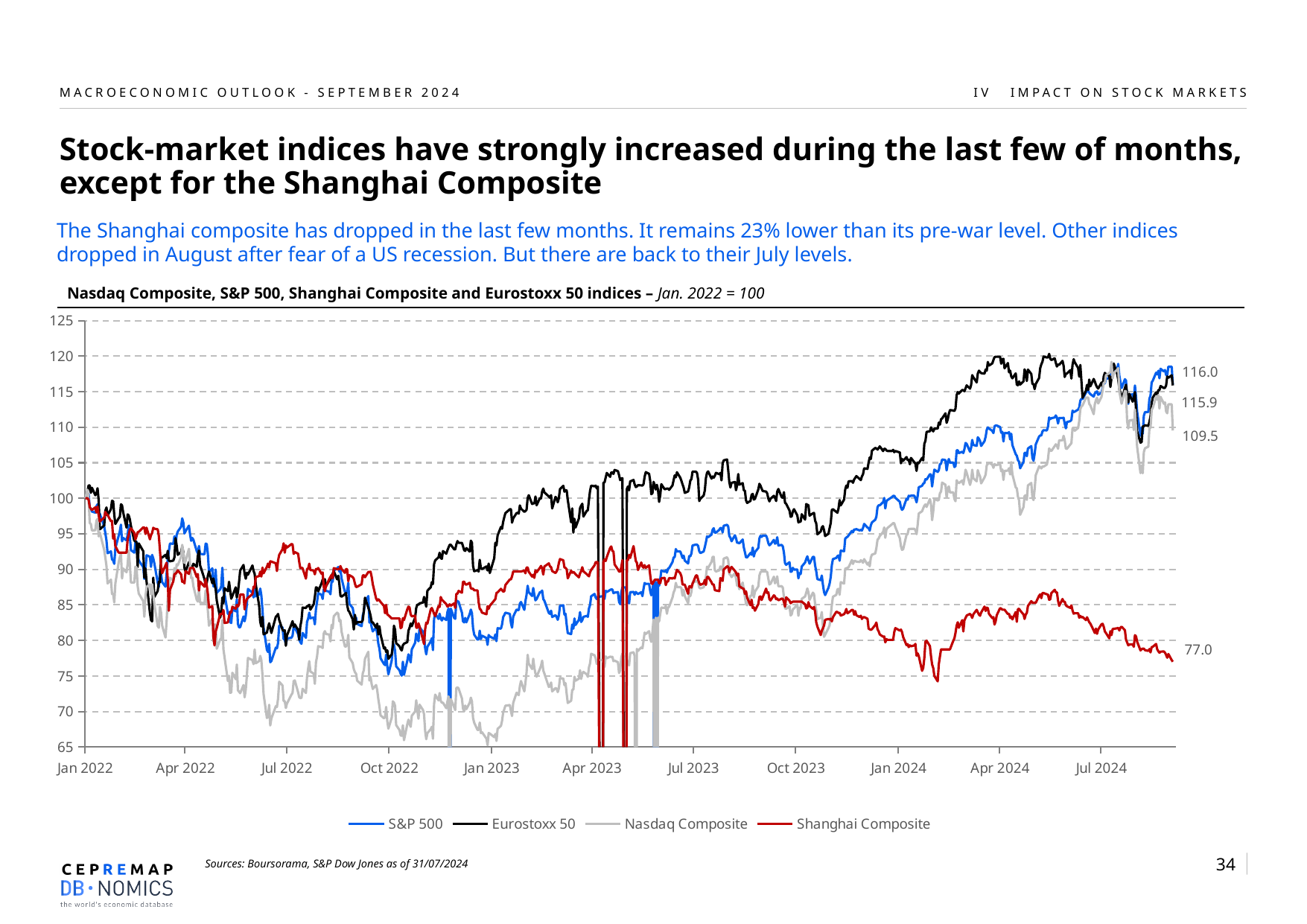
What base period is the index set to 100, according to the chart title? Jan. 2022 = 100 What is the final labelled value of the Nasdaq Composite index? 109.5 Does the Shanghai Composite rise or fall between Jan 2022 and the end of the period shown? fall What is the difference between the final labelled values of the Nasdaq Composite (109.5) and the Shanghai Composite (77.0)? 32.5 What colour is the Shanghai Composite line in the chart? red At the end of the period, which is larger: the S&P 500 or the Shanghai Composite? S&P 500 How many series does the legend list? 4 Is the final value of the Shanghai Composite greater or less than 80? less Which index has the lowest value at the end of the period shown? Shanghai Composite What is the final labelled value of the Shanghai Composite index? 77.0 Is the final value of the S&P 500 greater or less than 110? greater What kind of chart is shown on the slide? line chart